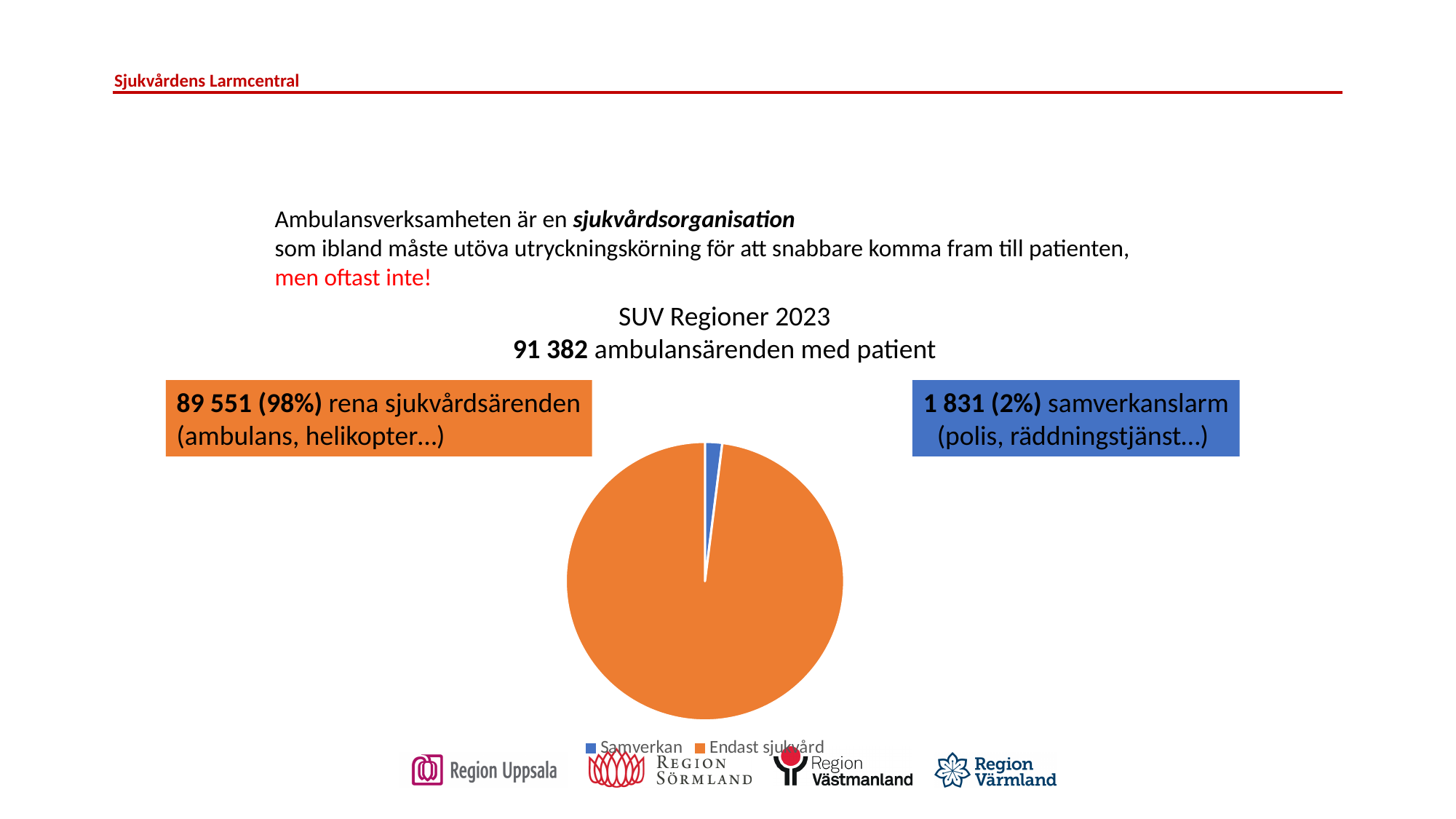
Which slice of the pie chart is the largest? Endast sjukvård How many entries does the legend of the pie chart list? 2 How many slices does the pie chart have? 2 What share of the pie does the Endast sjukvård slice represent? 98% What share of the pie does the Samverkan slice represent? 2% Which slice of the pie chart is the smallest? Samverkan How many samverkanslarm (Samverkan) cases are shown on the slide? 1 831 What kind of chart is shown on the slide? pie chart What is the total number of ambulansärenden med patient shown for SUV Regioner 2023? 91 382 How many rena sjukvårdsärenden (Endast sjukvård) cases are shown on the slide? 89 551 What colour is the Samverkan slice in the pie chart? blue Which is larger, the number of Samverkan cases or the number of Endast sjukvård cases? Endast sjukvård